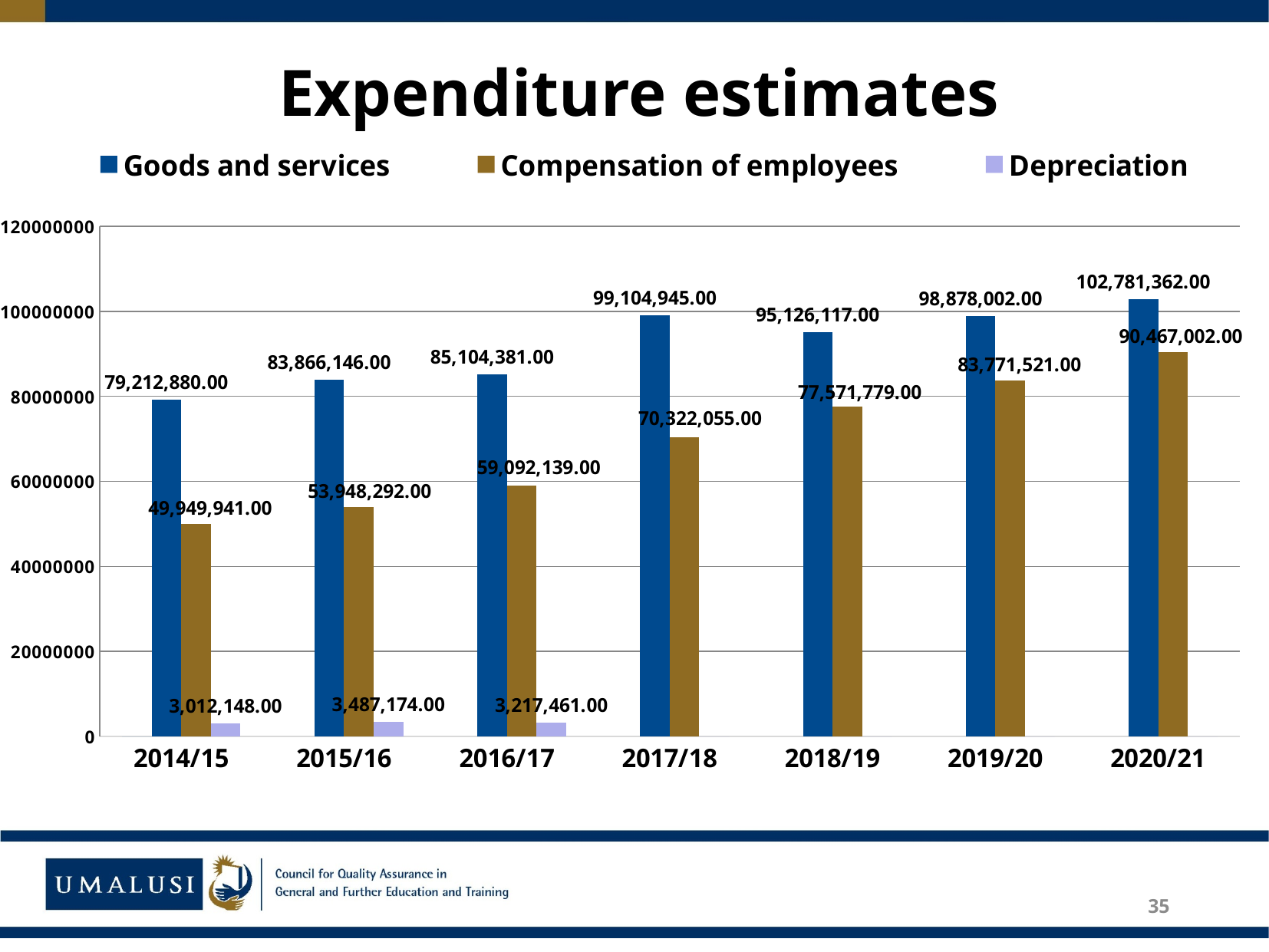
What is the value for Compensation of employees in 2020/21? 90,467,002.00 In which year is Compensation of employees lowest? 2014/15 How many years are shown on the x axis? 7 Which year has the larger value for Goods and services, 2018/19 or 2019/20? 2019/20 In which year is Depreciation highest? 2015/16 What kind of chart is shown on the slide? Bar chart How many series does the legend list? 3 What is the difference between Goods and services and Compensation of employees in 2014/15? 29,262,939.00 What is the value for Goods and services in 2017/18? 99,104,945.00 Do the values for Compensation of employees rise or fall from 2014/15 to 2020/21? Rise In which year is Goods and services highest? 2020/21 What is the value for Depreciation in 2015/16? 3,487,174.00